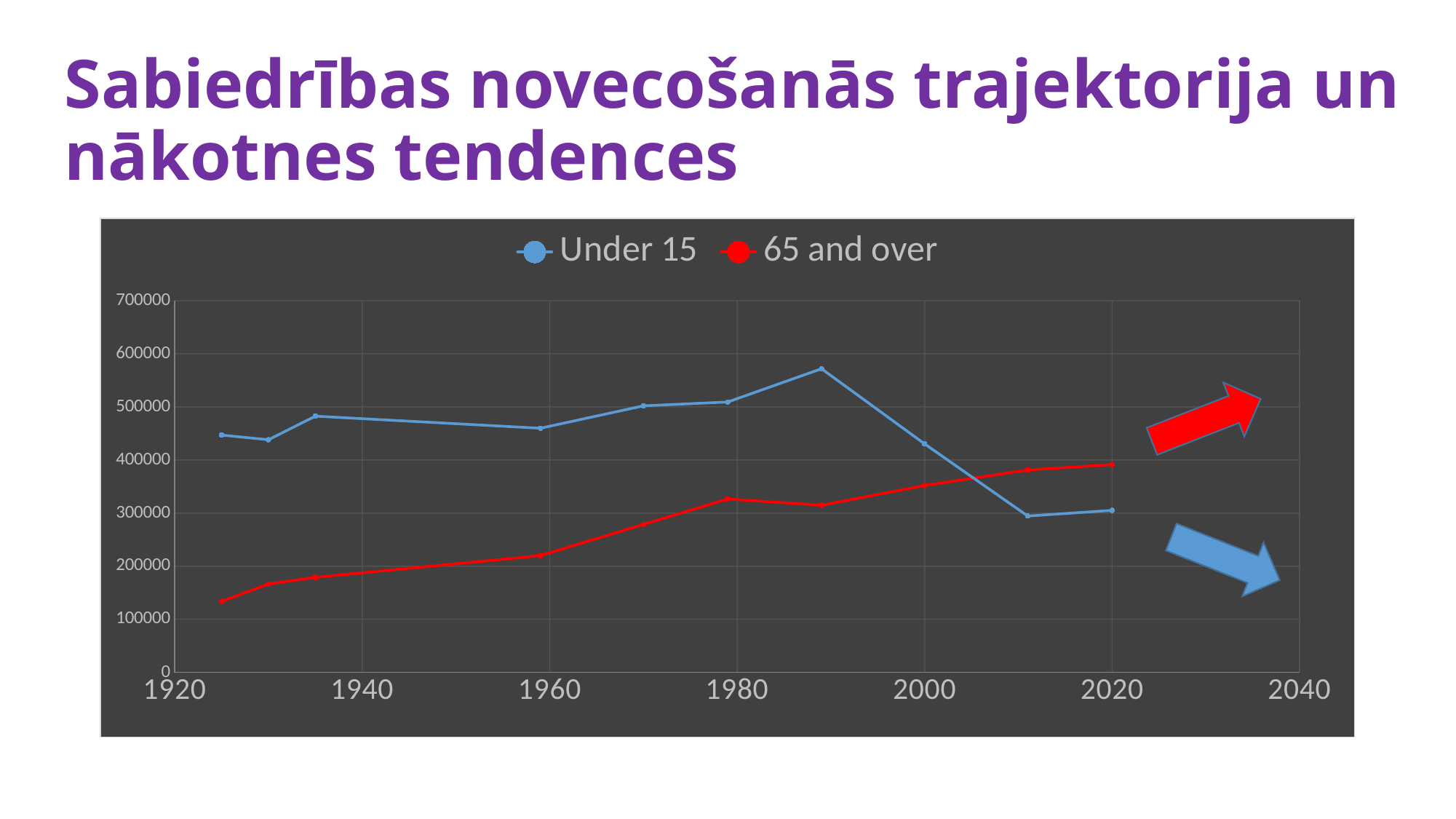
How many series does the legend list? 2 At 1980, which series has the higher value, Under 15 or 65 and over? Under 15 Is the last (rightmost) value of the Under 15 series greater or less than 400000? less What are the two series named in the legend? Under 15 and 65 and over Does the 65 and over series generally rise or fall from 1920 to 2020? rise Is the last (rightmost) value of the 65 and over series greater or less than 300000? greater What kind of chart is shown on the slide? line chart Is the highest value of the Under 15 series greater or less than 500000? greater Which colour is used for the 65 and over series? red At 2020, which series has the higher value, Under 15 or 65 and over? 65 and over Which series reaches the highest value plotted on the chart? Under 15